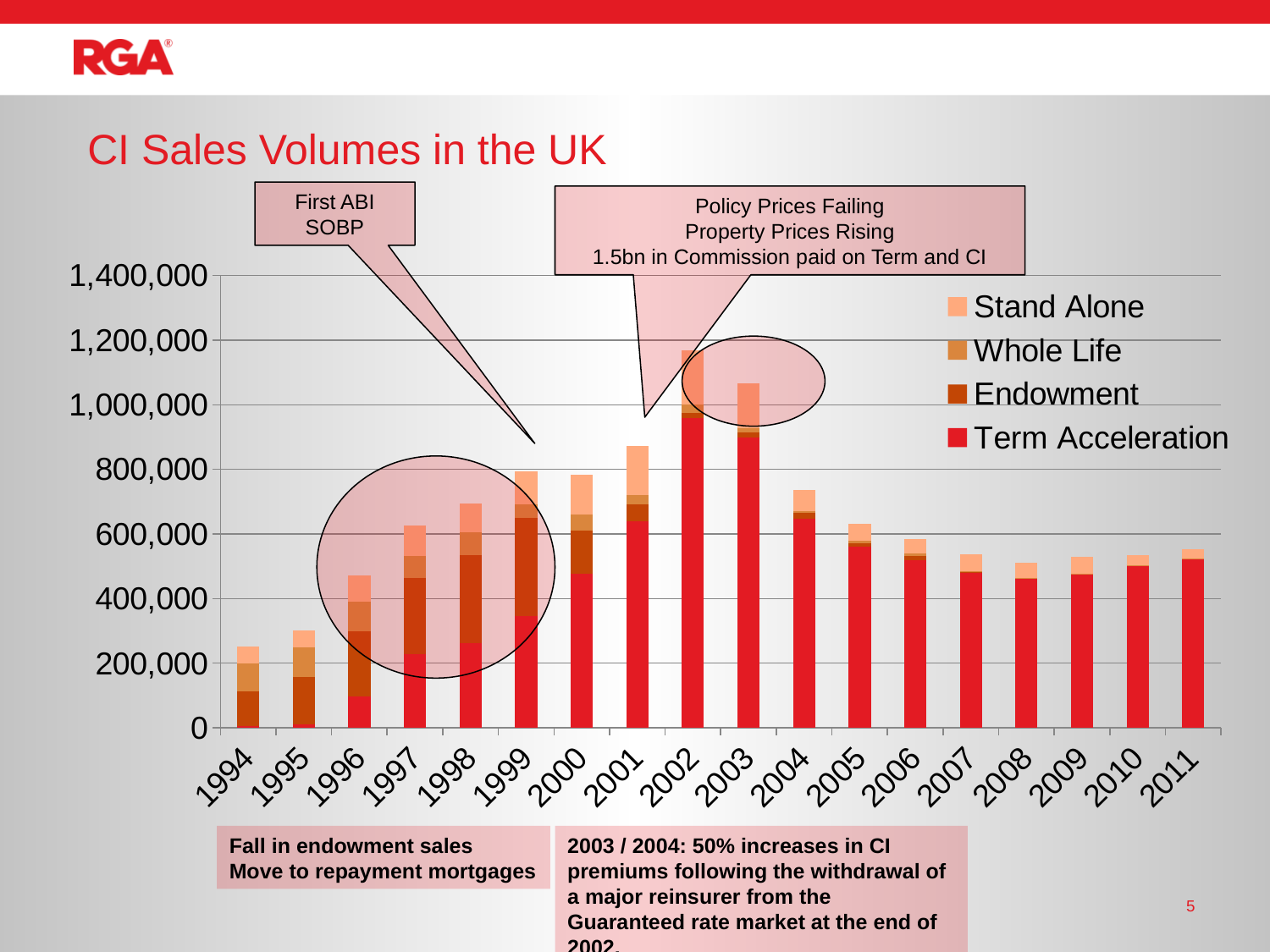
Is the total value for 1994 greater or less than 400,000? less Which year has the lowest total CI sales volume? 1994 Do the total CI sales volumes rise or fall from 2003 to 2008? fall How many years are shown on the x axis of the chart? 18 How many series does the legend list? 4 Is the total value for 2001 greater or less than 800,000? greater Which year has the highest total CI sales volume? 2002 Is the total value for 2002 greater or less than 1,000,000? greater What is the title of the chart? CI Sales Volumes in the UK Which year has the larger total CI sales volume, 2002 or 2003? 2002 What kind of chart is shown on the slide? Stacked bar chart